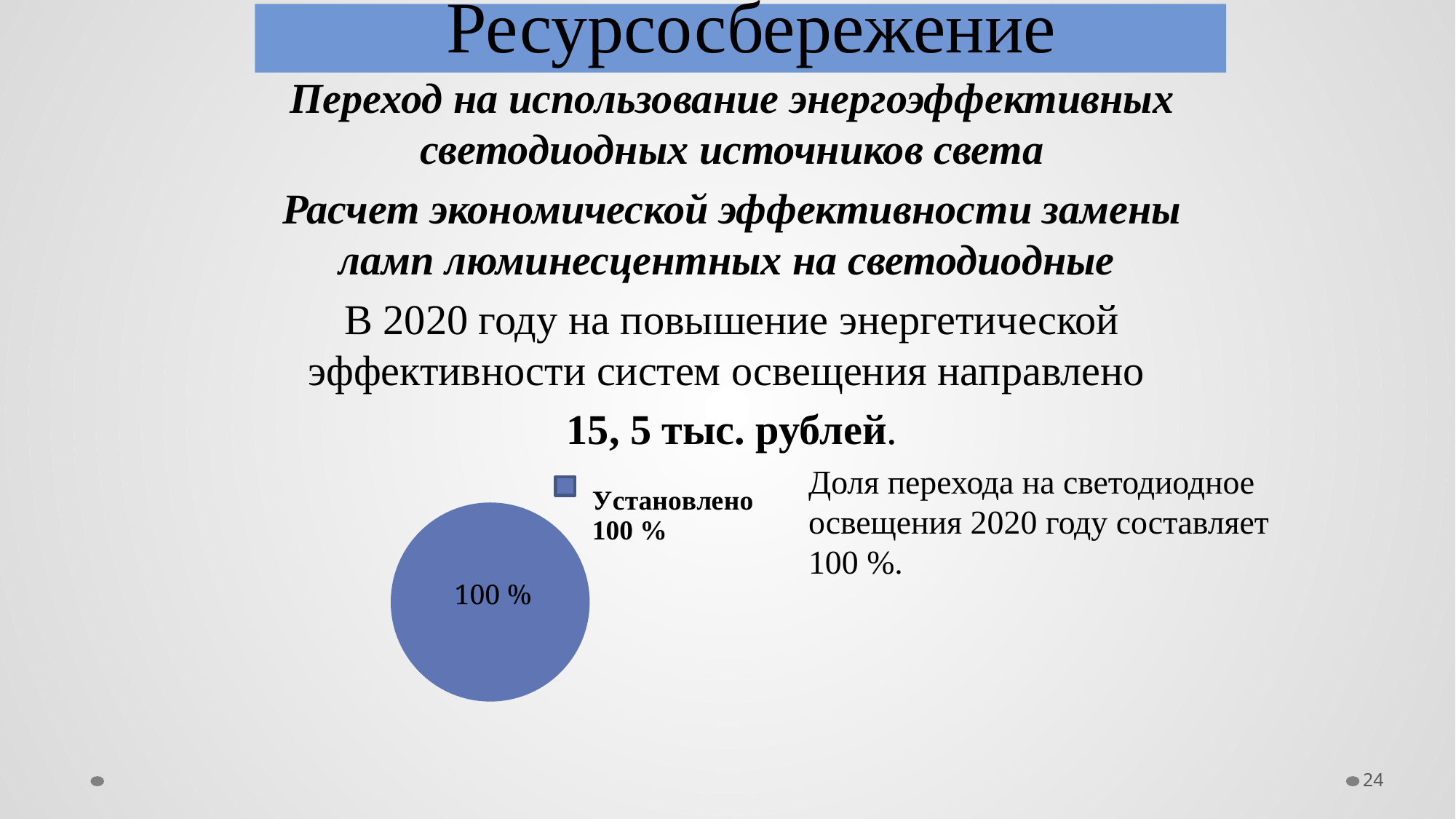
How many entries does the legend list? 1 What is the legend entry for the pie chart? Установлено 100 % How many slices does the pie chart have? 1 What share of the pie does the 'Установлено' slice take? 100 % What value is printed on the pie slice? 100 % What kind of chart is shown on the slide? pie chart What colour is the pie slice? blue